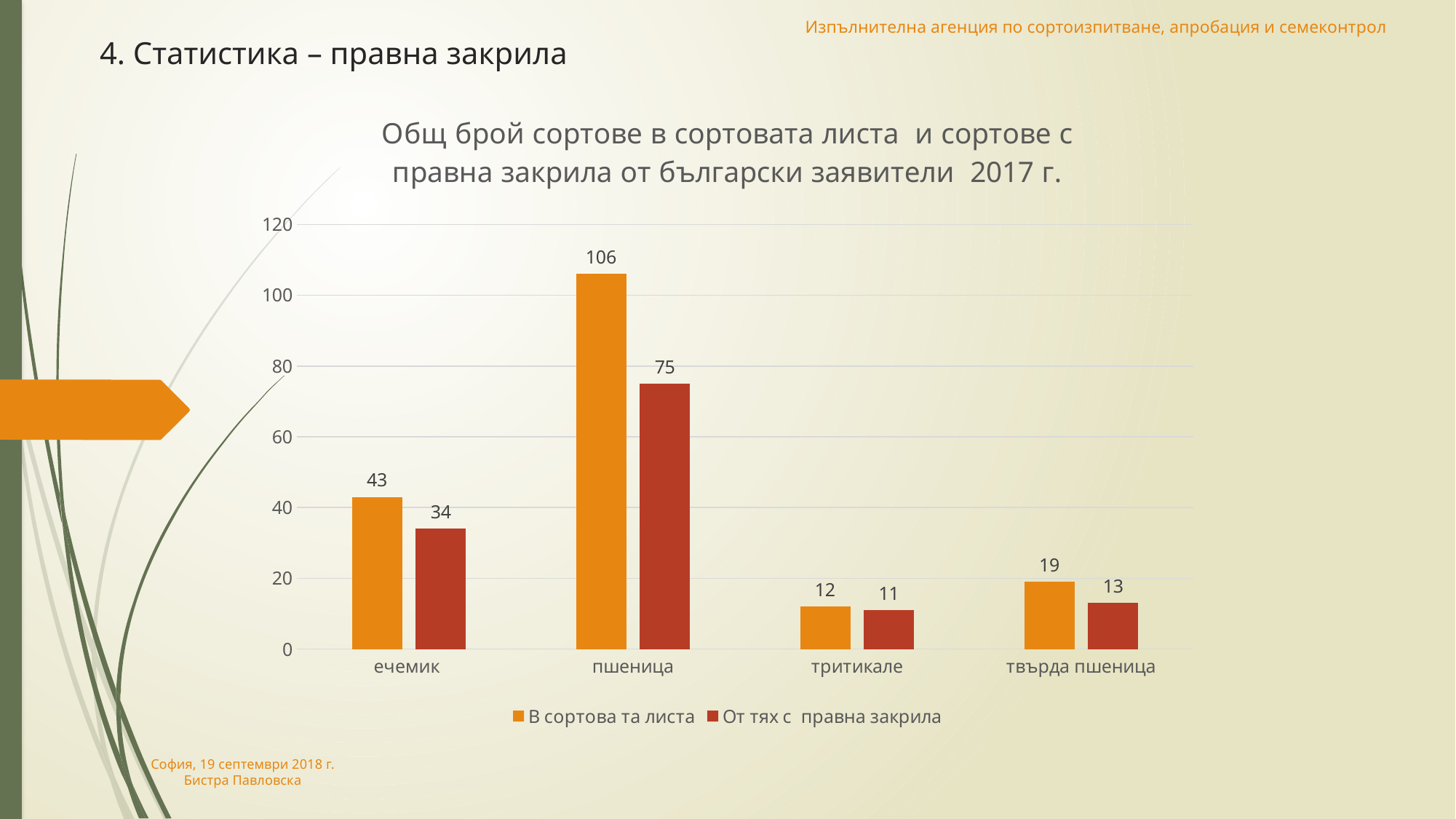
Is the value for ечемик in the series 'В сортова та листа' greater or less than 40? greater What is the value for твърда пшеница in the series 'В сортова та листа'? 19 What is the value for пшеница in the series 'В сортова та листа'? 106 Which is larger for тритикале: 'В сортова та листа' or 'От тях с правна закрила'? В сортова та листа What is the difference between the two series values for пшеница? 31 What colour are the bars for the series 'От тях с правна закрила'? red How many categories are shown on the x axis? 4 What kind of chart is shown on the slide? bar chart What is the value for ечемик in the series 'От тях с правна закрила'? 34 Which category has the highest value in the series 'В сортова та листа'? пшеница How many series does the legend list? 2 Which category has the lowest value in the series 'От тях с правна закрила'? тритикале